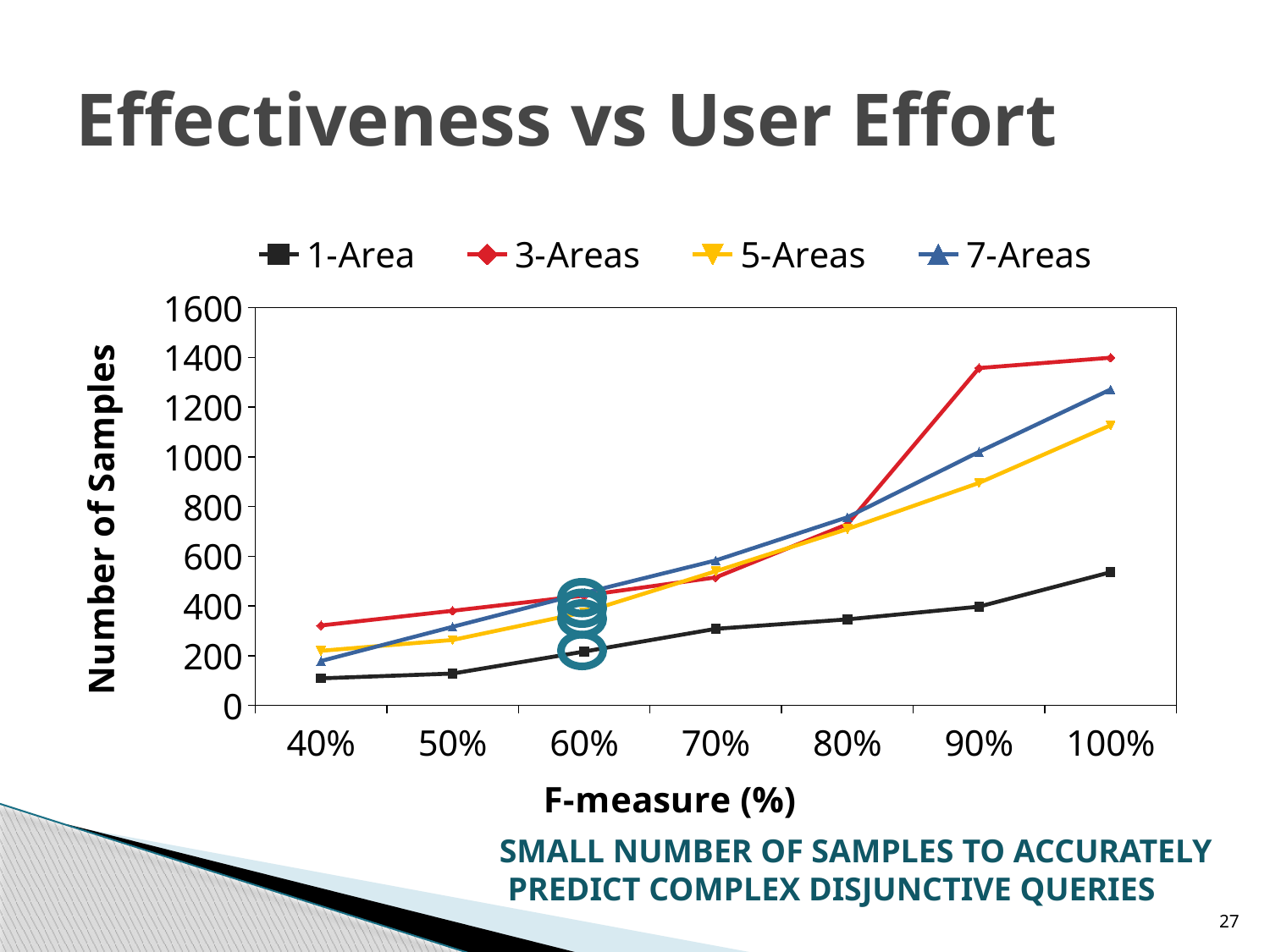
How many F-measure values are plotted along the x axis? 7 At an F-measure of 40%, which series has more samples, 3-Areas or 1-Area? 3-Areas What kind of chart is shown on the slide? line chart Which series has the lowest number of samples at an F-measure of 100%? 1-Area How many series does the legend list? 4 What is the title of the y axis? Number of Samples At an F-measure of 100%, which series has more samples, 7-Areas or 5-Areas? 7-Areas Which series has the highest number of samples at an F-measure of 100%? 3-Areas Does the number of samples for 1-Area rise or fall as the F-measure increases from 40% to 100%? rise Is the number of samples for 1-Area at an F-measure of 100% greater or less than 600? less Is the number of samples for 3-Areas at an F-measure of 90% greater or less than 1200? greater Is the number of samples for 5-Areas at an F-measure of 90% greater or less than 1000? less